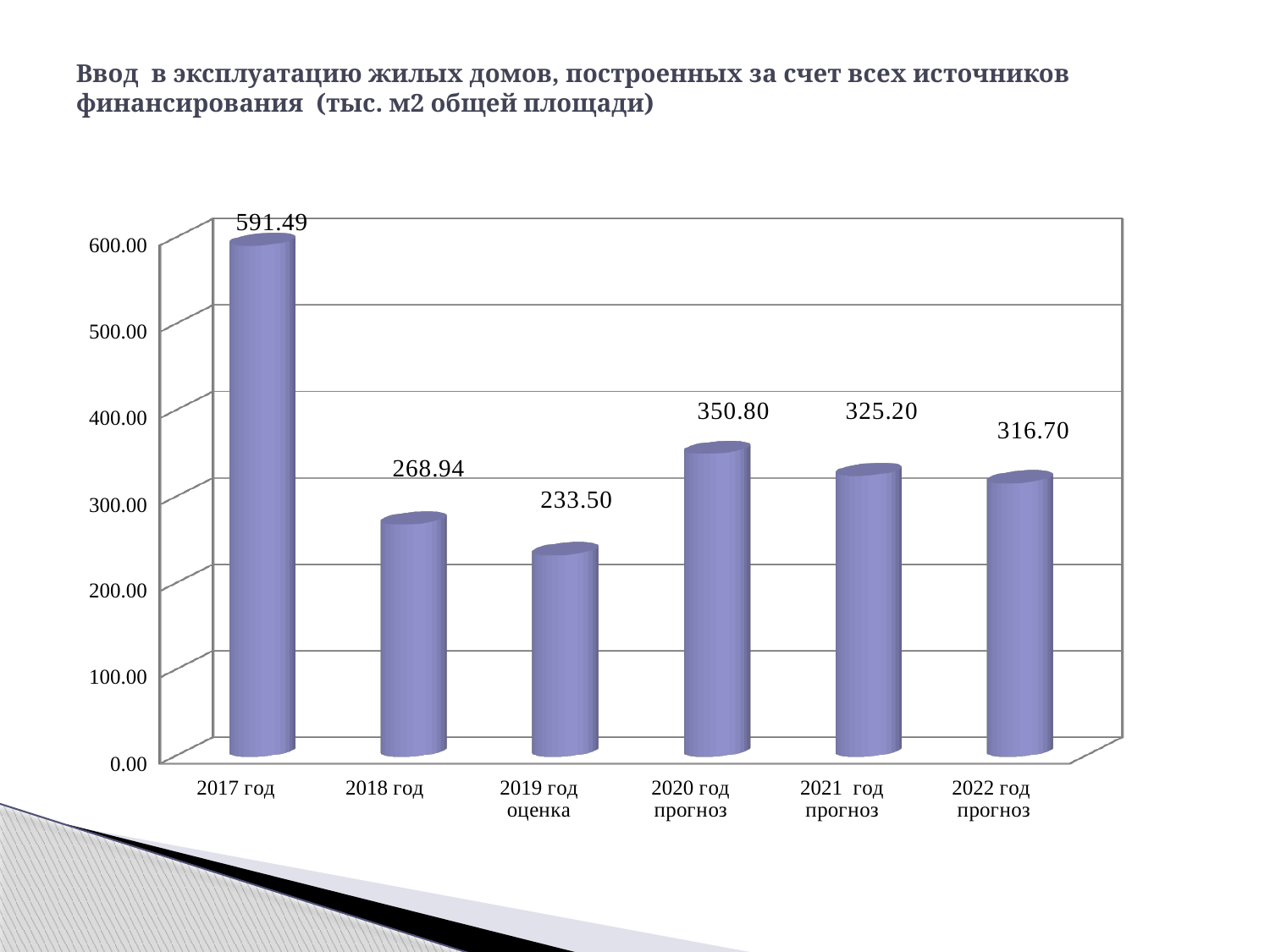
Which is larger, the value for 2018 год or the value for 2022 год прогноз? 2022 год прогноз What is the difference between the values for 2020 год прогноз and 2021 год прогноз? 25.60 What is the value for 2017 год? 591.49 What is the difference between the values for 2017 год and 2018 год? 322.55 Is the value for 2020 год прогноз greater or less than 300.00? greater Which year has the lowest value? 2019 год оценка Do the values rise or fall from 2020 год прогноз to 2022 год прогноз? fall What is the value for 2019 год оценка? 233.50 What kind of chart is shown on the slide? bar chart What is the value for 2022 год прогноз? 316.70 How many years are shown on the chart? 6 Which year has the highest value? 2017 год